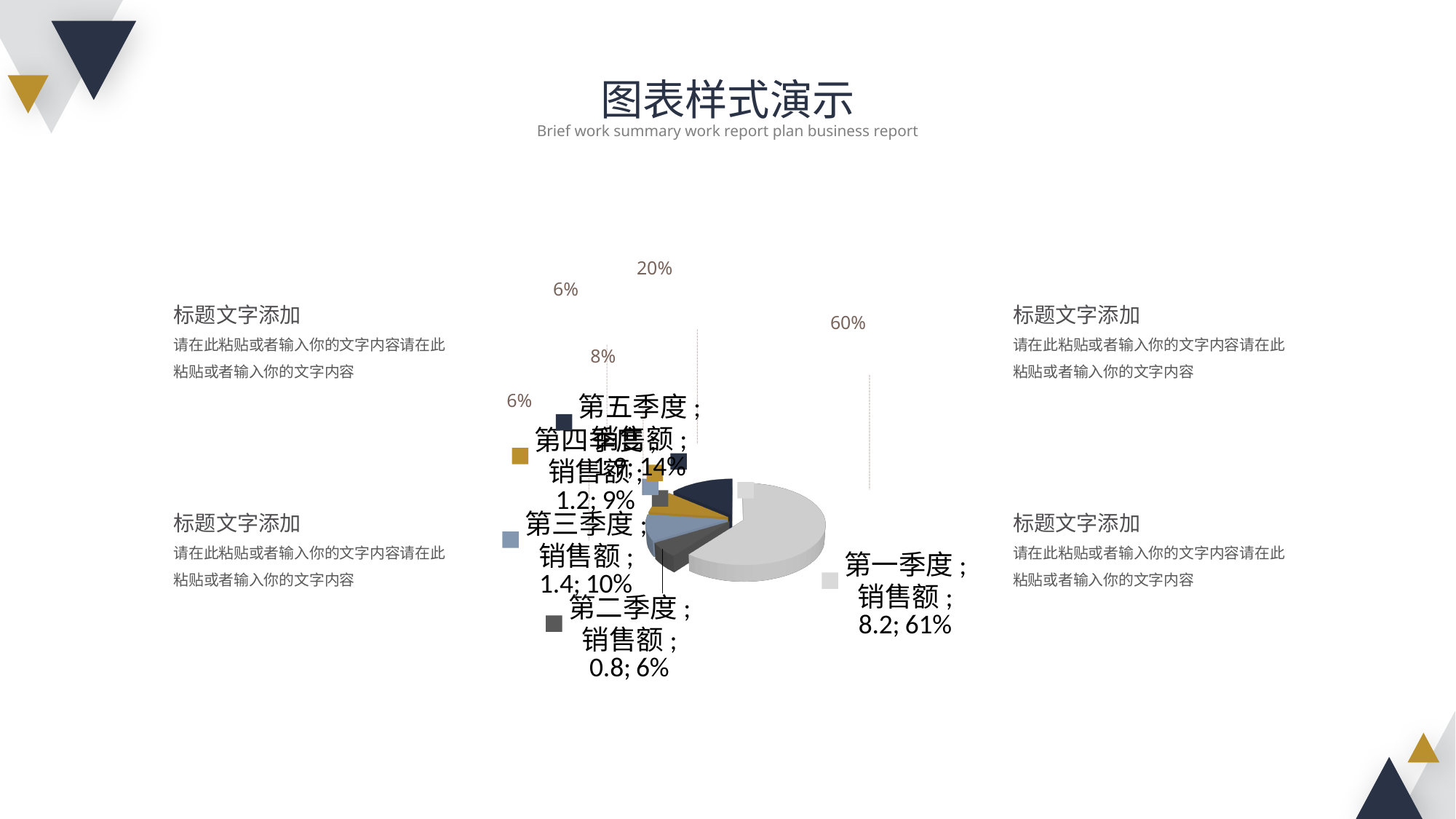
What is the difference between the values for 第一季度 and 第二季度? 7.4 What is the title of the slide? 图表样式演示 What is the 销售额 value for 第三季度? 1.4 How many slices does the pie chart have? 5 What is the 销售额 value for 第二季度? 0.8 Which is larger, the value for 第三季度 or 第四季度? 第三季度 What is the 销售额 value for 第一季度? 8.2 What share of the pie does 第三季度 take? 10% Which quarter has the largest slice of the pie? 第一季度 Which quarter has the smallest slice of the pie? 第二季度 What kind of chart is shown on the slide? pie chart What share of the pie does 第一季度 take? 61%